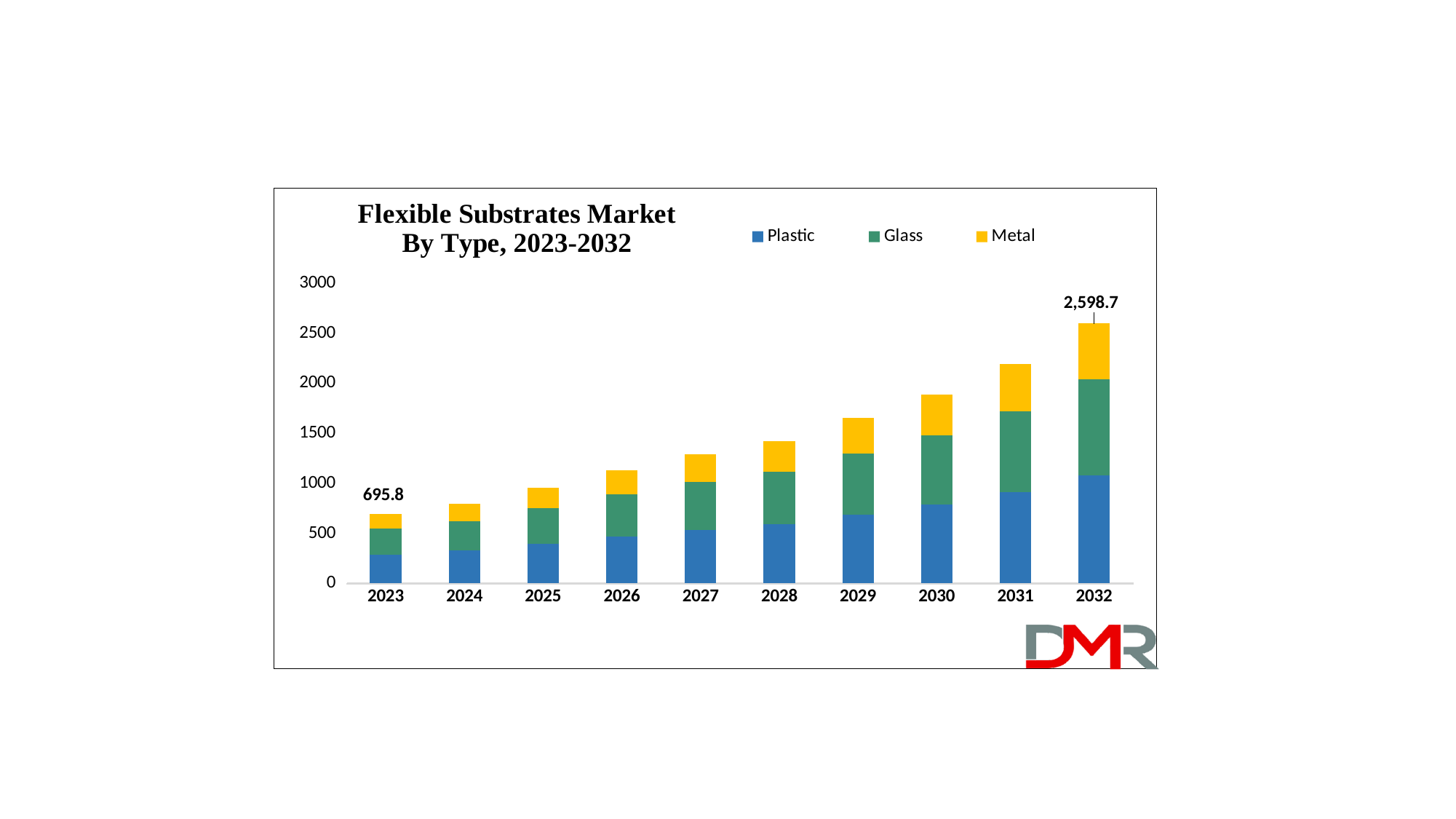
Which year has the larger total bar, 2029 or 2031? 2031 What kind of chart is shown on the slide? Stacked bar chart Which year has the lowest total bar? 2023 What is the difference between the labelled totals for 2032 and 2023? 1,902.9 Do the total bar heights rise or fall from 2023 to 2032? Rise What is the total market value labelled for 2032? 2,598.7 What is the total market value labelled for 2023? 695.8 How many series does the legend list? 3 How many years are shown on the x axis? 10 Which series is shown in yellow in the legend? Metal Is the total value for 2030 greater or less than 1500? greater Which year has the highest total bar? 2032